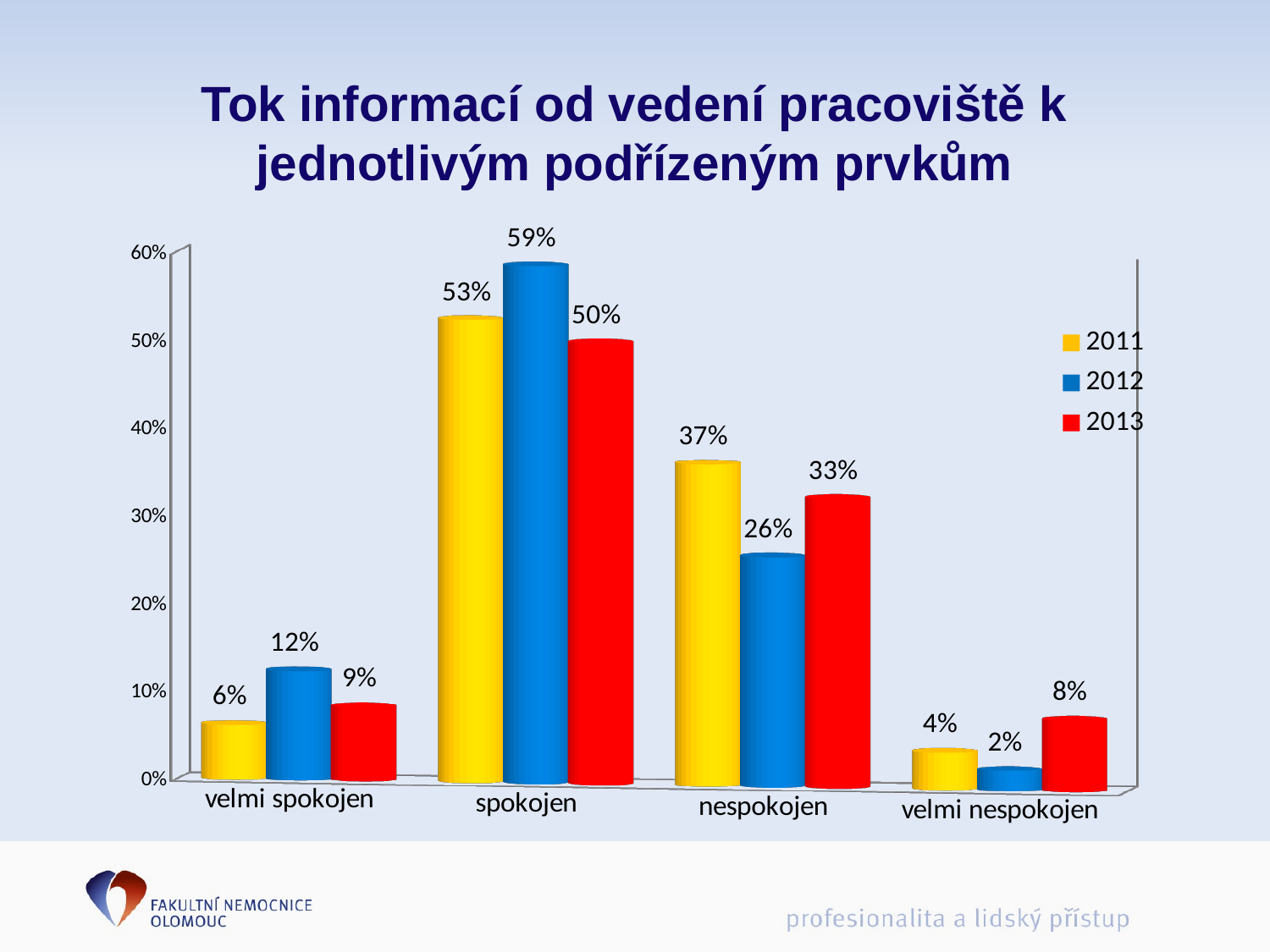
Is the value for 2013 in the 'nespokojen' category greater or less than 30%? greater Which colour represents the 2013 series in the legend? red What is the value for 2011 in the 'nespokojen' category? 37% Which category has the highest value for 2013? spokojen Which is larger in the 'velmi spokojen' category: the 2012 value or the 2013 value? 2012 Which category has the lowest value for 2012? velmi nespokojen What is the difference between the 2011 and 2012 values in the 'nespokojen' category? 11% How many categories are shown on the x axis? 4 How many series does the legend list? 3 What is the value for 2012 in the 'spokojen' category? 59% What is the value for 2013 in the 'velmi nespokojen' category? 8% What kind of chart is shown on the slide? bar chart